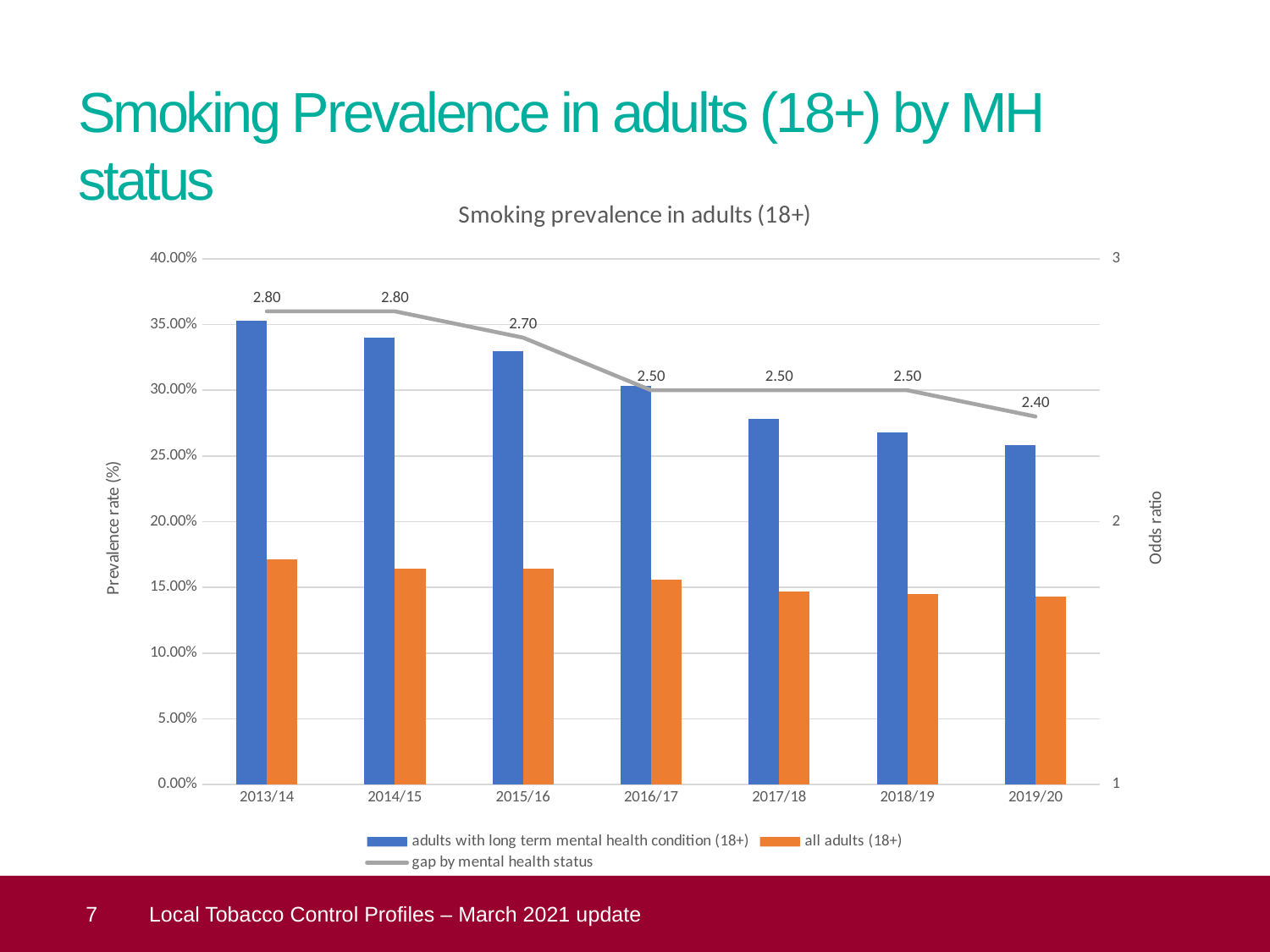
Does smoking prevalence for adults with a long term mental health condition rise or fall from 2013/14 to 2019/20? Fall What is the value of the gap by mental health status in 2019/20? 2.40 What is the value of the gap by mental health status in 2015/16? 2.70 What kind of chart is this? Bar chart with a line How many series does the legend list? 3 Is the value for all adults (18+) in 2019/20 greater or less than 20%? less What is the label on the right-hand vertical axis? Odds ratio By how much did the gap by mental health status fall between 2013/14 and 2019/20? 0.40 What is the value of the gap by mental health status in 2013/14? 2.80 How many years are shown on the x axis? 7 Is the value for adults with long term mental health condition (18+) in 2013/14 greater or less than 30%? greater In which year is the gap by mental health status lowest? 2019/20